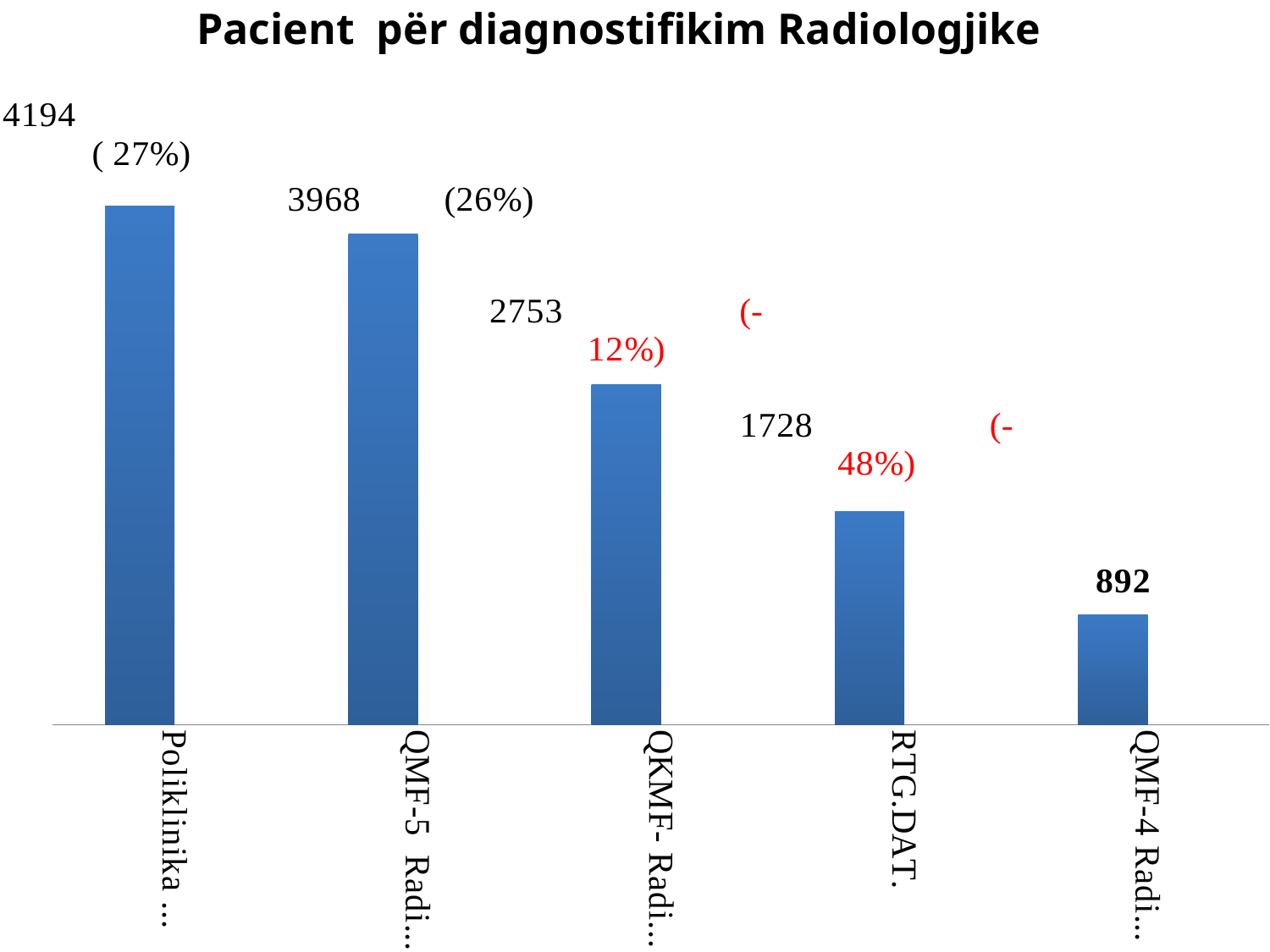
Which category has the lowest value? QMF-4 Which category has the highest value? Poliklinika What is the value for the QKMF bar? 2753 What is the difference between the QKMF value and the RTG.DAT. value? 1025 What is the value for RTG.DAT.? 1728 What kind of chart is shown on the slide? Bar chart What is the value for the QMF-4 bar? 892 Which is larger, the value for QMF-5 or the value for QKMF? QMF-5 What is the title of the chart? Pacient për diagnostifikim Radiologjike What is the difference between the Poliklinika value and the QMF-5 value? 226 How many bars are shown in the chart? 5 What is the value for the QMF-5 bar? 3968